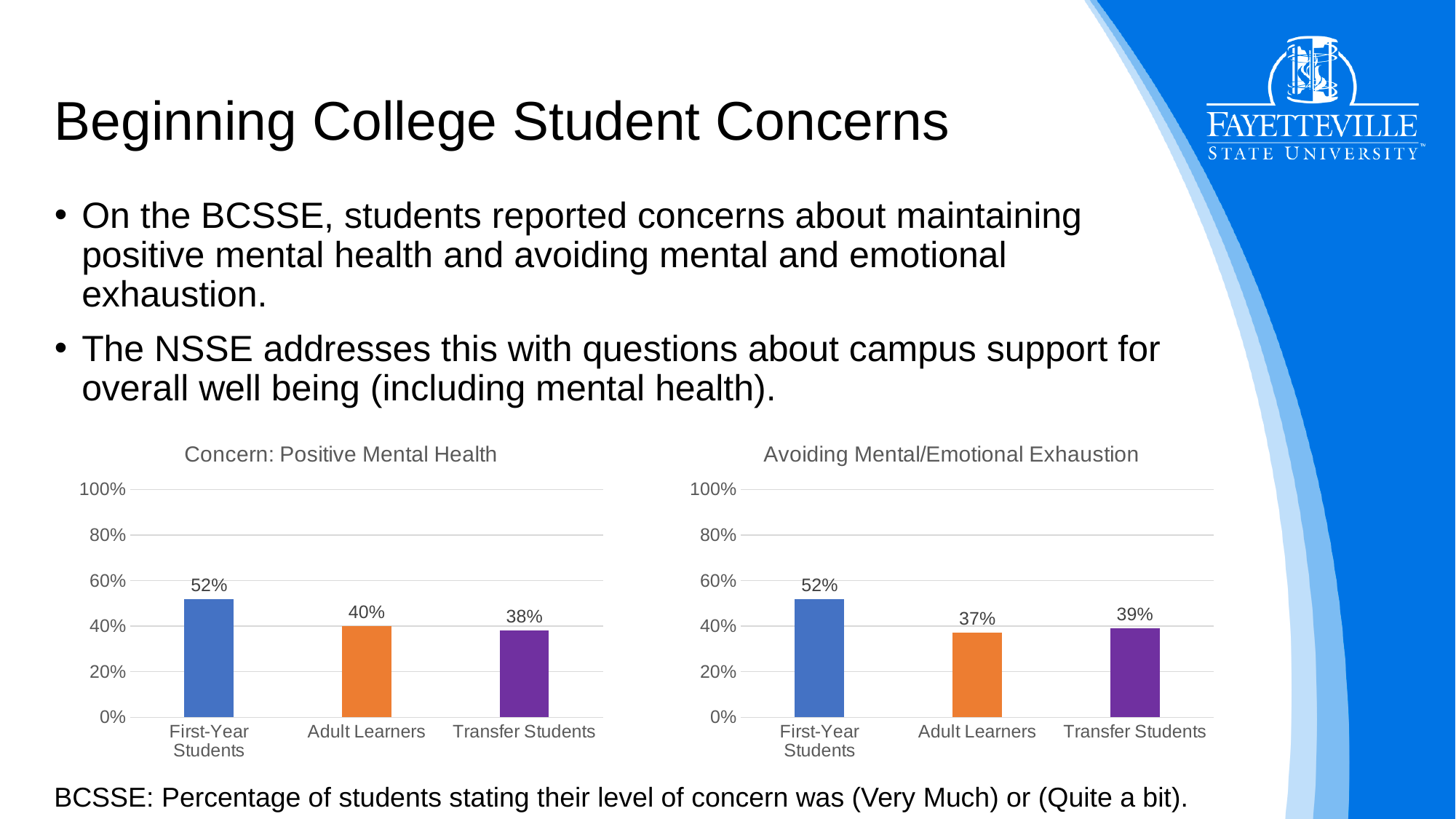
In the 'Concern: Positive Mental Health' chart, what is the value for First-Year Students? 52% What kind of chart is the 'Avoiding Mental/Emotional Exhaustion' chart? bar chart In the 'Avoiding Mental/Emotional Exhaustion' chart, which category has the lowest value? Adult Learners In the 'Avoiding Mental/Emotional Exhaustion' chart, what is the value for Adult Learners? 37% In the 'Avoiding Mental/Emotional Exhaustion' chart, what is the value for Transfer Students? 39% In the 'Avoiding Mental/Emotional Exhaustion' chart, is the value for First-Year Students greater or less than 40%? greater In the 'Concern: Positive Mental Health' chart, what is the difference between the values for First-Year Students and Transfer Students? 14% How many categories are shown in the 'Concern: Positive Mental Health' chart? 3 In the 'Concern: Positive Mental Health' chart, which is larger, the value for Adult Learners or the value for Transfer Students? Adult Learners In the 'Avoiding Mental/Emotional Exhaustion' chart, what is the difference between the values for First-Year Students and Adult Learners? 15% In the 'Concern: Positive Mental Health' chart, which category has the highest value? First-Year Students In the 'Concern: Positive Mental Health' chart, what is the value for Adult Learners? 40%